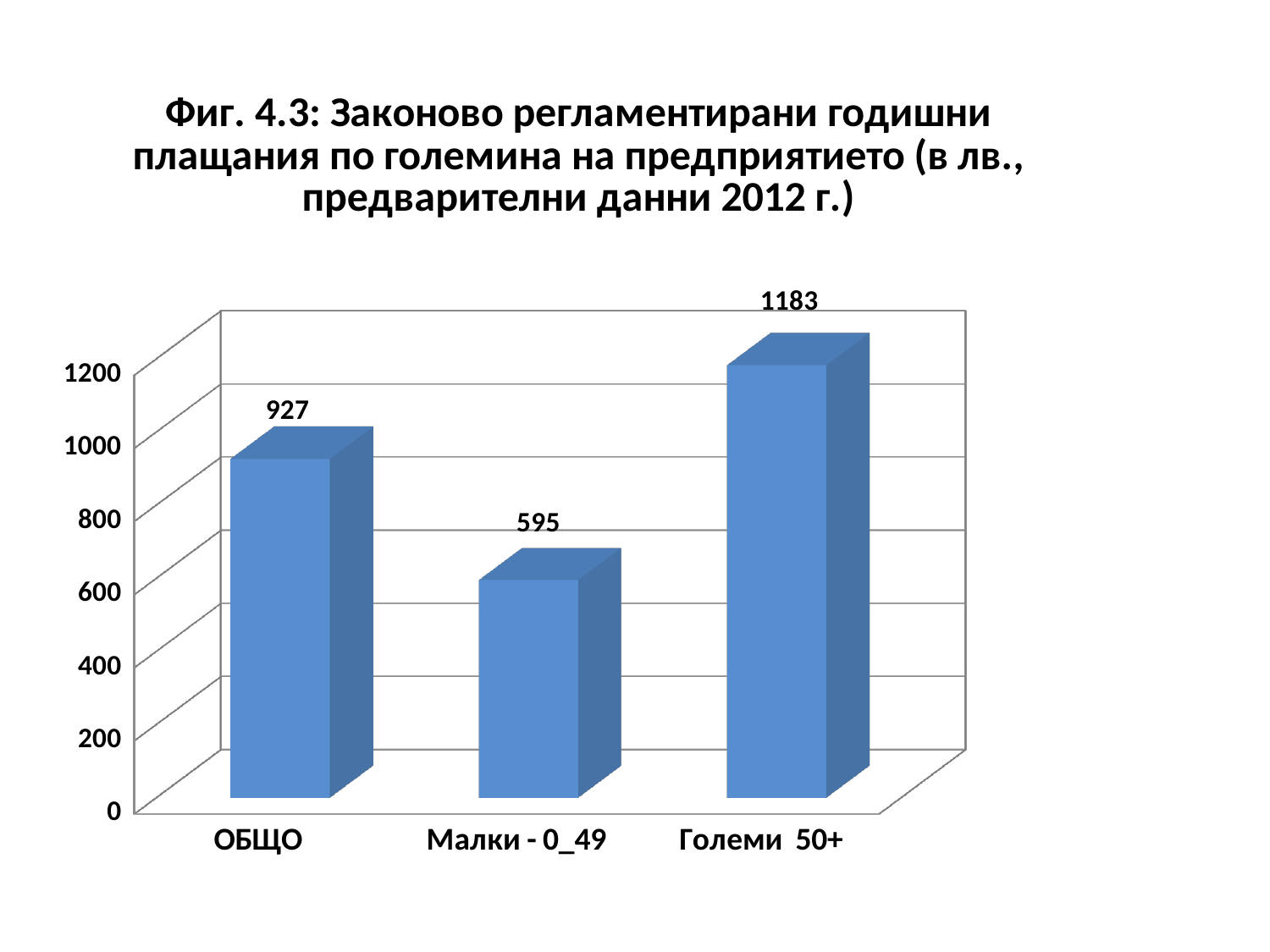
Which category has the highest value? Големи 50+ Is the value for Малки - 0_49 greater or less than 800? less Which is larger, the value for ОБЩО or the value for Големи 50+? Големи 50+ What is the value for ОБЩО? 927 What is the value for Големи 50+? 1183 What is the difference between the values for ОБЩО and Малки - 0_49? 332 What is the figure number given in the chart title? Фиг. 4.3 Which category has the lowest value? Малки - 0_49 What is the value for Малки - 0_49? 595 How many categories are shown on the x axis? 3 What is the difference between the values for Големи 50+ and Малки - 0_49? 588 What kind of chart is shown on the slide? bar chart